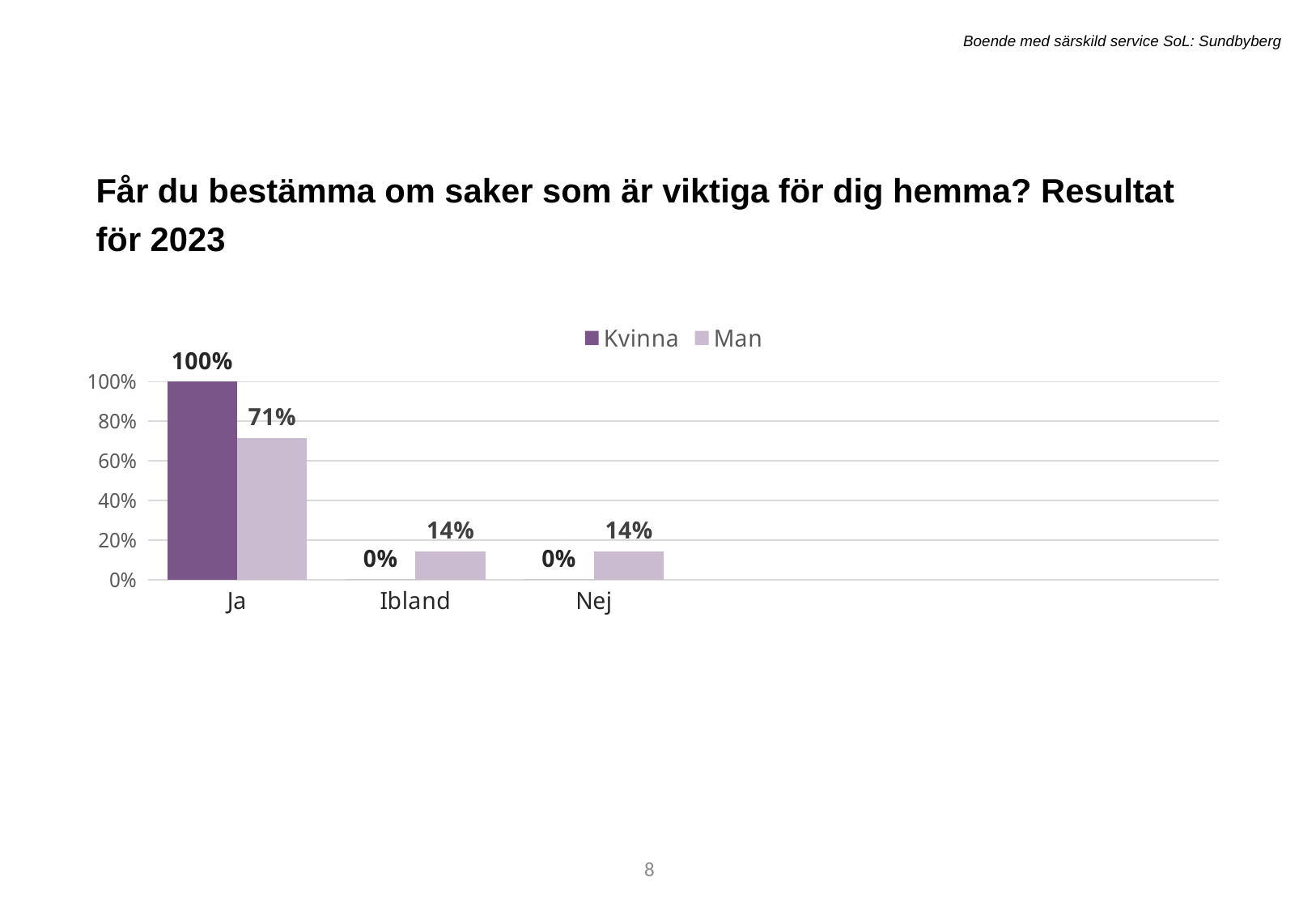
What are the two series named in the legend? Kvinna and Man What is the value for Kvinna in the Nej category? 0% How many series does the legend list? 2 What is the value for Man in the Ibland category? 14% Is the value for Man in the Ja category greater or less than 60%? greater Which is larger in the Ja category, Kvinna or Man? Kvinna Which category has the highest value for Man? Ja What is the value for Kvinna in the Ja category? 100% What is the value for Man in the Ja category? 71% How many categories are shown on the x axis? 3 What is the difference between the Kvinna and Man values in the Ja category? 29% What kind of chart is shown on the slide? Bar chart